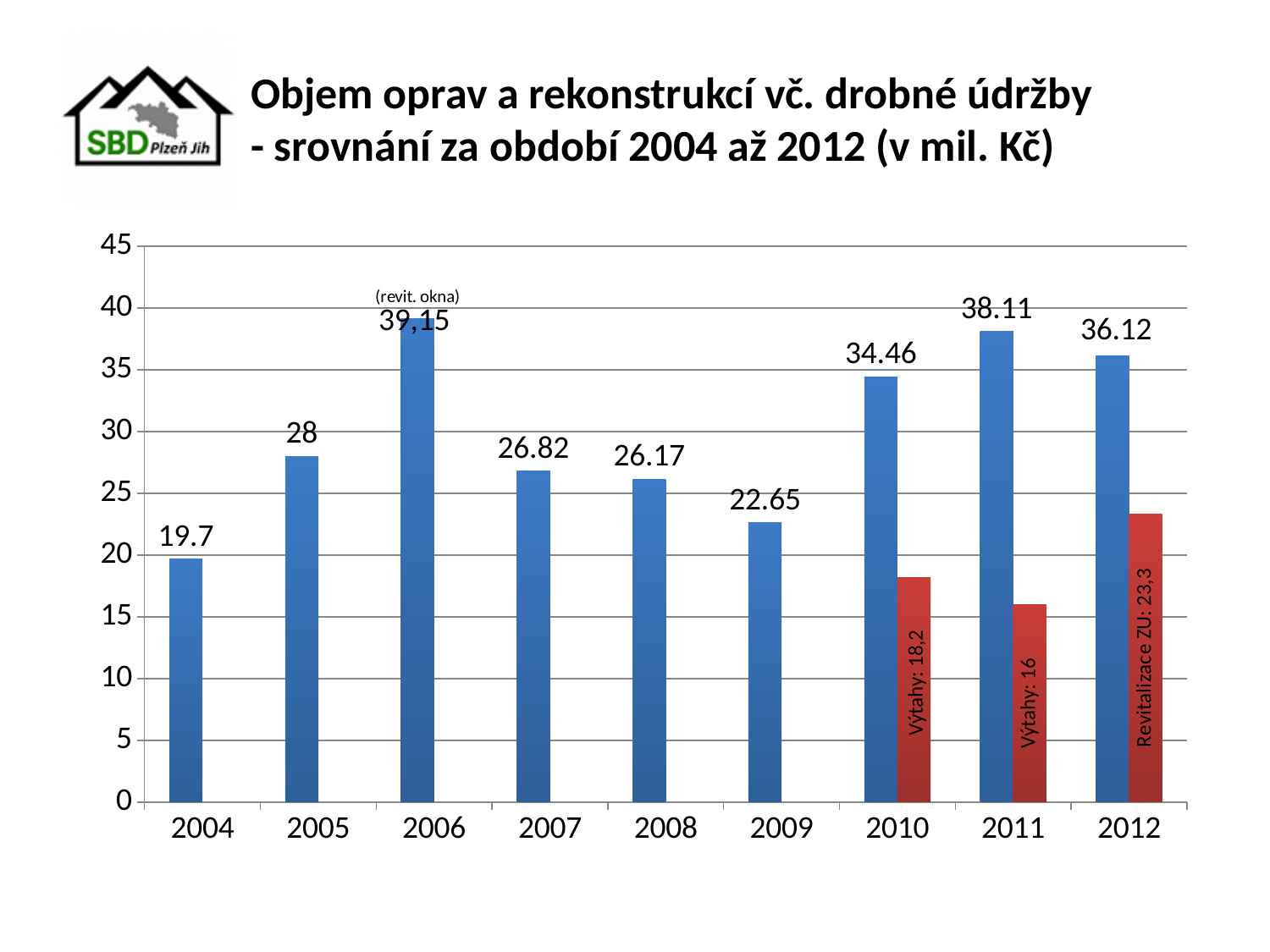
What is the value of the blue bar for 2004? 19.7 What is the value of the blue bar for 2009? 22.65 What is the value labelled on the red bar for 2012? 23,3 Which is larger, the blue bar for 2007 or the blue bar for 2008? 2007 Is the value of the blue bar for 2005 greater or less than 25? greater What is the difference between the blue bar values for 2011 and 2010? 3.65 Which year has the highest blue bar? 2006 What kind of chart is shown on the slide? bar chart Which year has the lowest blue bar? 2004 What is the value of the blue bar for 2011? 38.11 What annotation is written above the 2006 bar? (revit. okna) How many years are shown on the x axis? 9